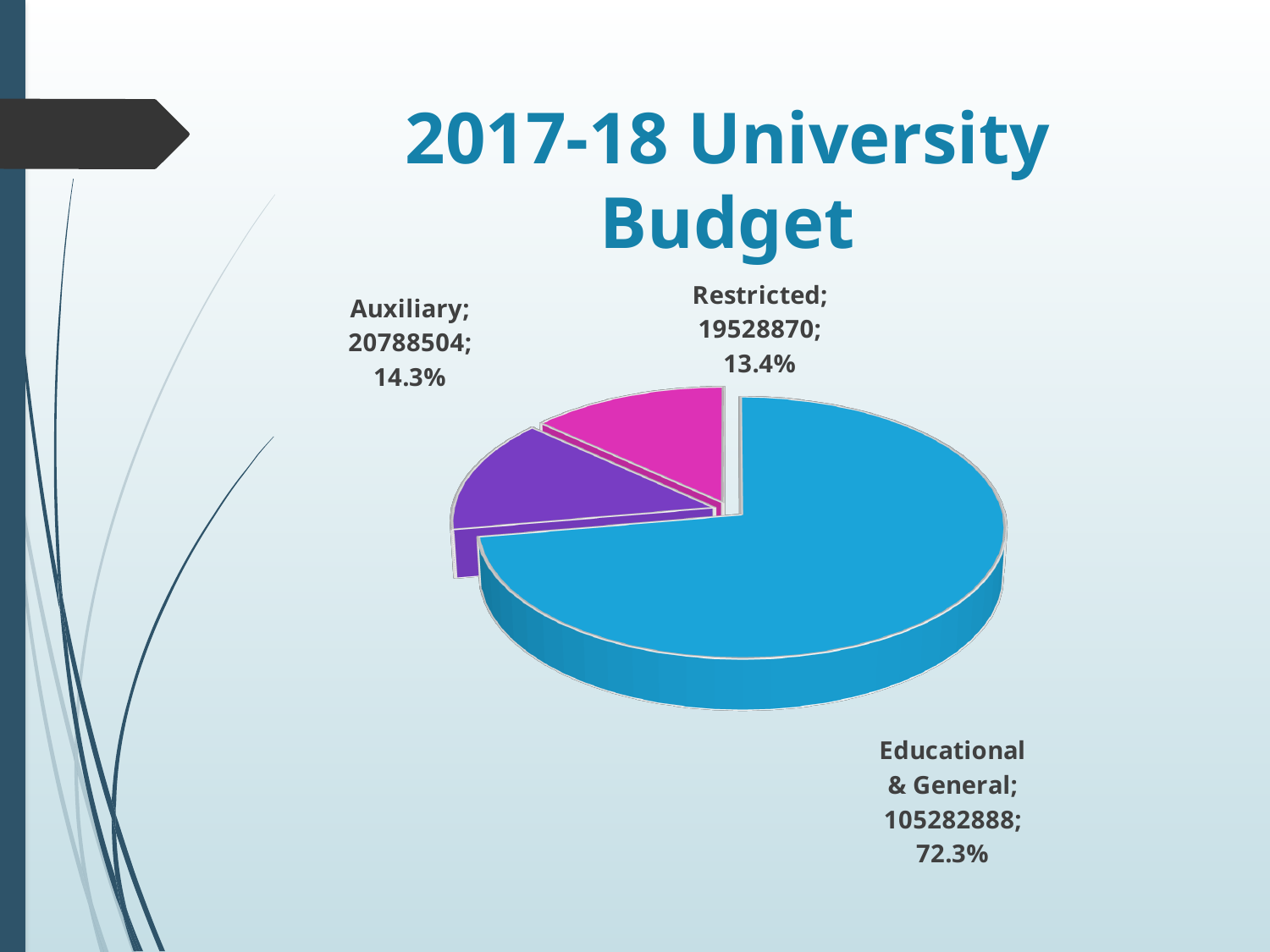
What is the difference between the Auxiliary and Restricted values? 1259634 What is the value for Educational & General? 105282888 What is the title of the chart? 2017-18 University Budget Which category has the largest slice? Educational & General What share of the pie does Educational & General represent? 72.3% What colour is the Restricted slice? Magenta Which is larger, Auxiliary or Restricted? Auxiliary What share of the pie does Auxiliary represent? 14.3% Which category has the smallest slice? Restricted How many categories are shown in the pie chart? 3 What is the value for Restricted? 19528870 What kind of chart is shown on the slide? Pie chart